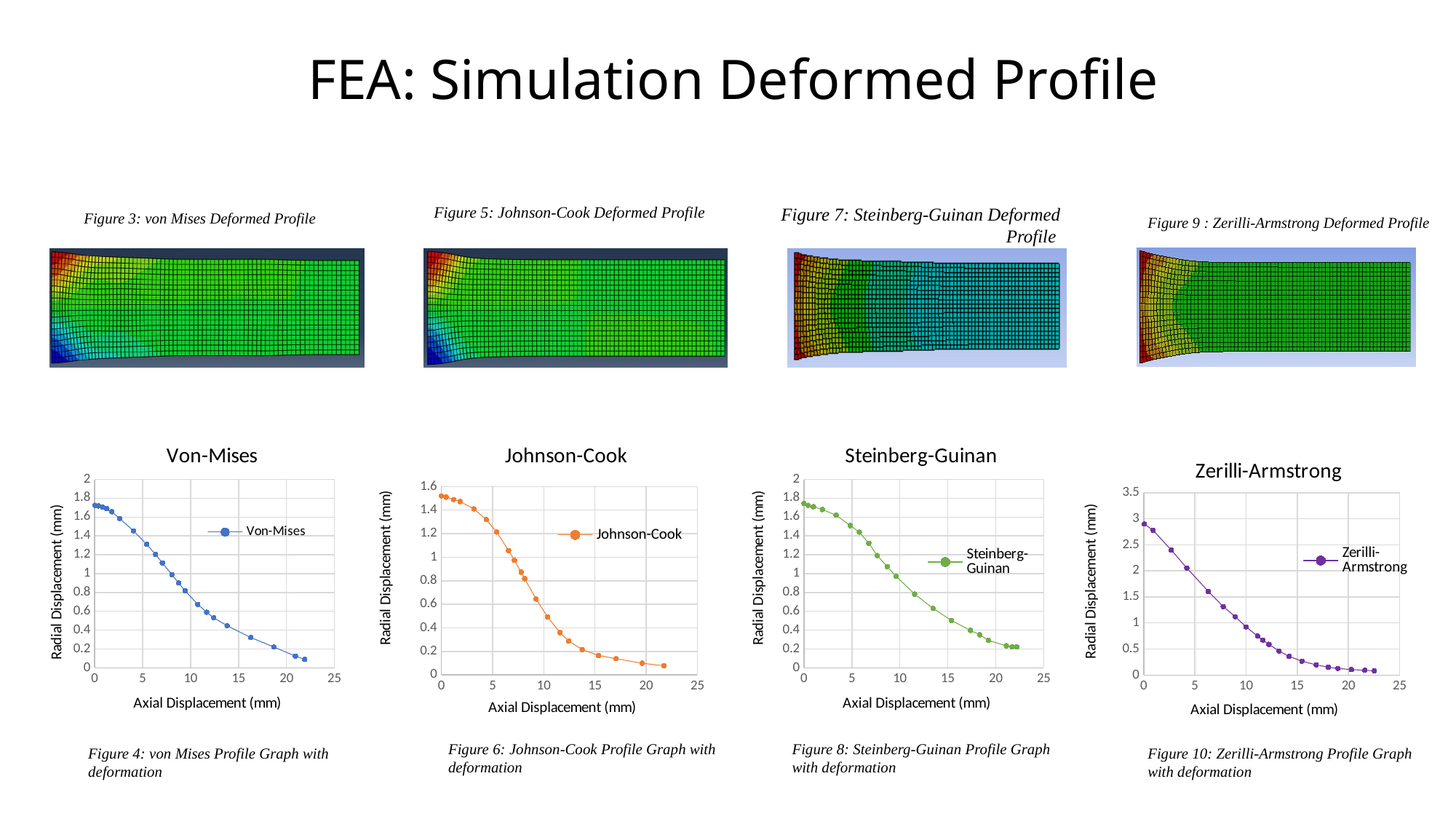
In the Steinberg-Guinan chart, is the radial displacement at an axial displacement of 0 mm greater or less than 1.5? greater In the Johnson-Cook chart, does radial displacement rise or fall along the x axis? fall In the Von-Mises chart, does radial displacement rise or fall as axial displacement increases? fall Which of the four charts has the highest radial displacement at an axial displacement of 0 mm? Zerilli-Armstrong How many series does the legend of the Johnson-Cook chart list? 1 In the Von-Mises chart, is the radial displacement at an axial displacement of 0 mm greater or less than 1.5? greater In the Zerilli-Armstrong chart, is the radial displacement at an axial displacement of 0 mm greater or less than 2.5? greater What kind of chart is the Von-Mises chart? line chart What is the y-axis label of the Steinberg-Guinan chart? Radial Displacement (mm) What is the x-axis label of the Zerilli-Armstrong chart? Axial Displacement (mm)